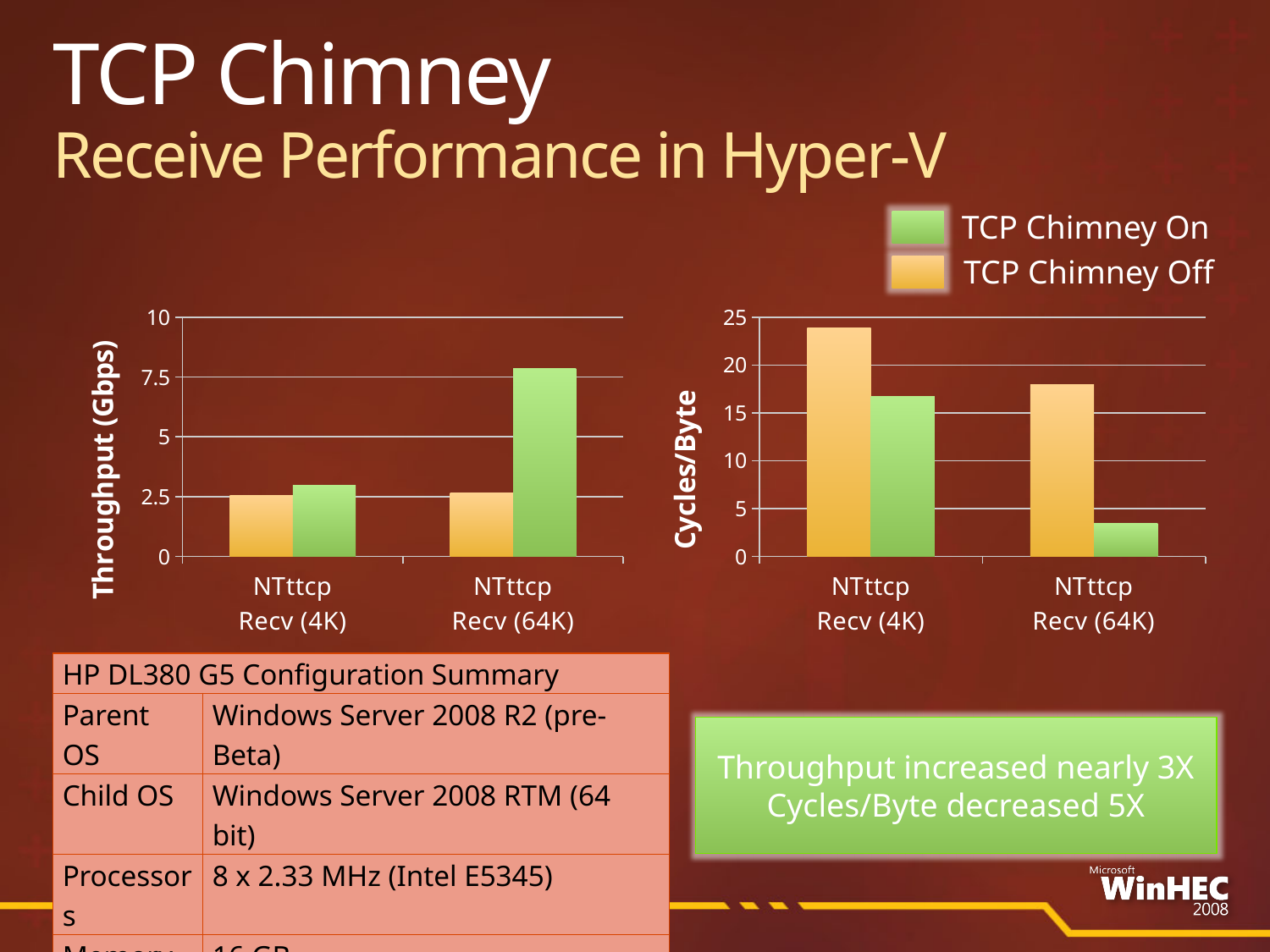
In the Cycles/Byte chart on the right, is the TCP Chimney Off value for NTttcp Recv (4K) greater or less than 20? greater What type of chart is the Throughput (Gbps) chart on the left? bar chart In the Cycles/Byte chart on the right, is the TCP Chimney On value for NTttcp Recv (64K) greater or less than 5? less In the Throughput (Gbps) chart on the left, is the TCP Chimney Off value for NTttcp Recv (64K) greater or less than 5? less Which colour represents TCP Chimney Off in the legend? orange In the Cycles/Byte chart on the right, which bar is the lowest? TCP Chimney On for NTttcp Recv (64K) What is the y-axis label of the chart on the right? Cycles/Byte In the Cycles/Byte chart on the right, which is larger for NTttcp Recv (4K): TCP Chimney On or TCP Chimney Off? TCP Chimney Off In the Throughput (Gbps) chart on the left, which category has the highest TCP Chimney On throughput? NTttcp Recv (64K) How many categories are shown on the x axis of the Cycles/Byte chart on the right? 2 How many series does the legend list? 2